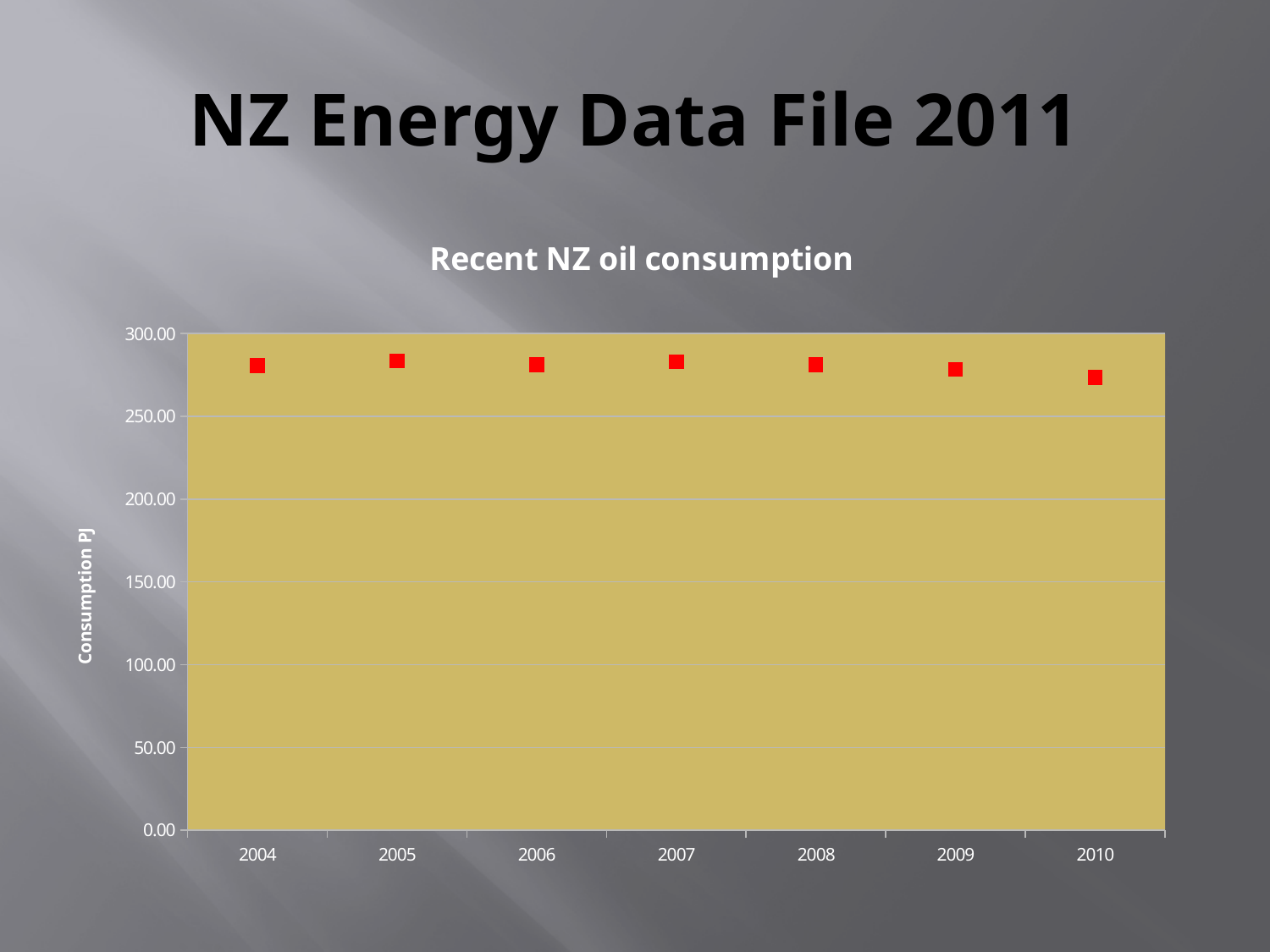
What is the label on the vertical axis of the chart? Consumption PJ Which is larger, the value for 2005 or the value for 2010? 2005 Is the value for 2004 greater or less than 250? greater Is the value for 2007 greater or less than 200? greater Is the value for 2010 higher or lower than the value for 2009? lower Is the value for 2010 greater or less than 300? less How many years are plotted on the x axis of the chart? 7 Which year has the lowest oil consumption in the chart? 2010 What kind of chart is shown on the slide? scatter chart What is the title of the chart? Recent NZ oil consumption Which is larger, the value for 2004 or the value for 2010? 2004 Between 2008 and 2010, do the plotted values rise or fall? fall